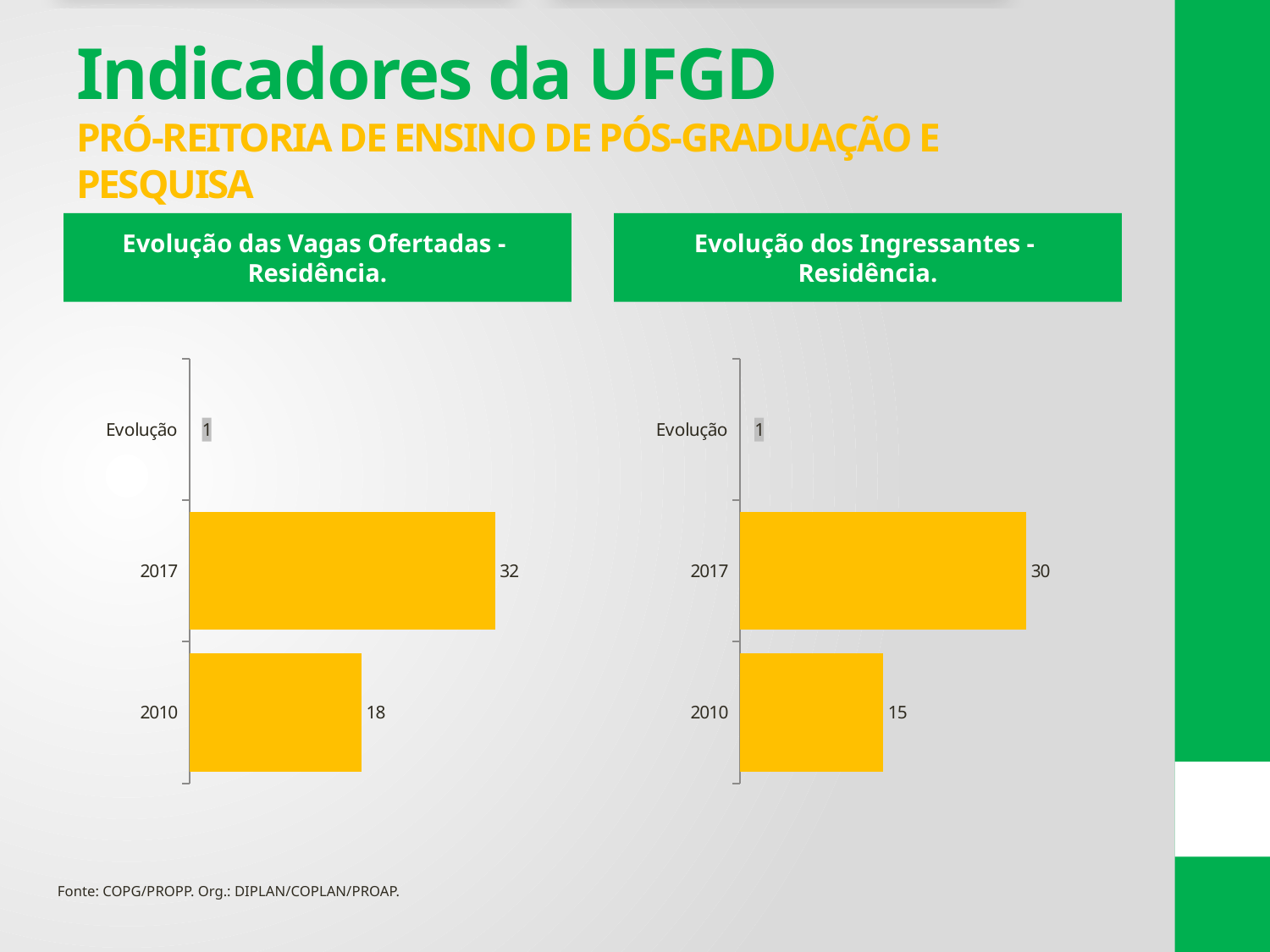
In the chart 'Evolução dos Ingressantes - Residência.', what is the difference between the 2017 and 2010 values? 15 In the chart 'Evolução dos Ingressantes - Residência.', what is the value for 2017? 30 What kind of chart is 'Evolução dos Ingressantes - Residência.'? Bar chart In the chart 'Evolução das Vagas Ofertadas - Residência.', what is the difference between the 2017 and 2010 values? 14 In the chart 'Evolução das Vagas Ofertadas - Residência.', which category has the highest value? 2017 How many categories are shown in the chart 'Evolução das Vagas Ofertadas - Residência.'? 3 In the chart 'Evolução dos Ingressantes - Residência.', which category has the lowest value? Evolução In the chart 'Evolução das Vagas Ofertadas - Residência.', what is the value for 2017? 32 In the chart 'Evolução dos Ingressantes - Residência.', what is the value for 2010? 15 In the chart 'Evolução das Vagas Ofertadas - Residência.', which year has the higher value, 2010 or 2017? 2017 What is the title of the chart on the right side of the slide? Evolução dos Ingressantes - Residência. In the chart 'Evolução das Vagas Ofertadas - Residência.', what is the value for 2010? 18